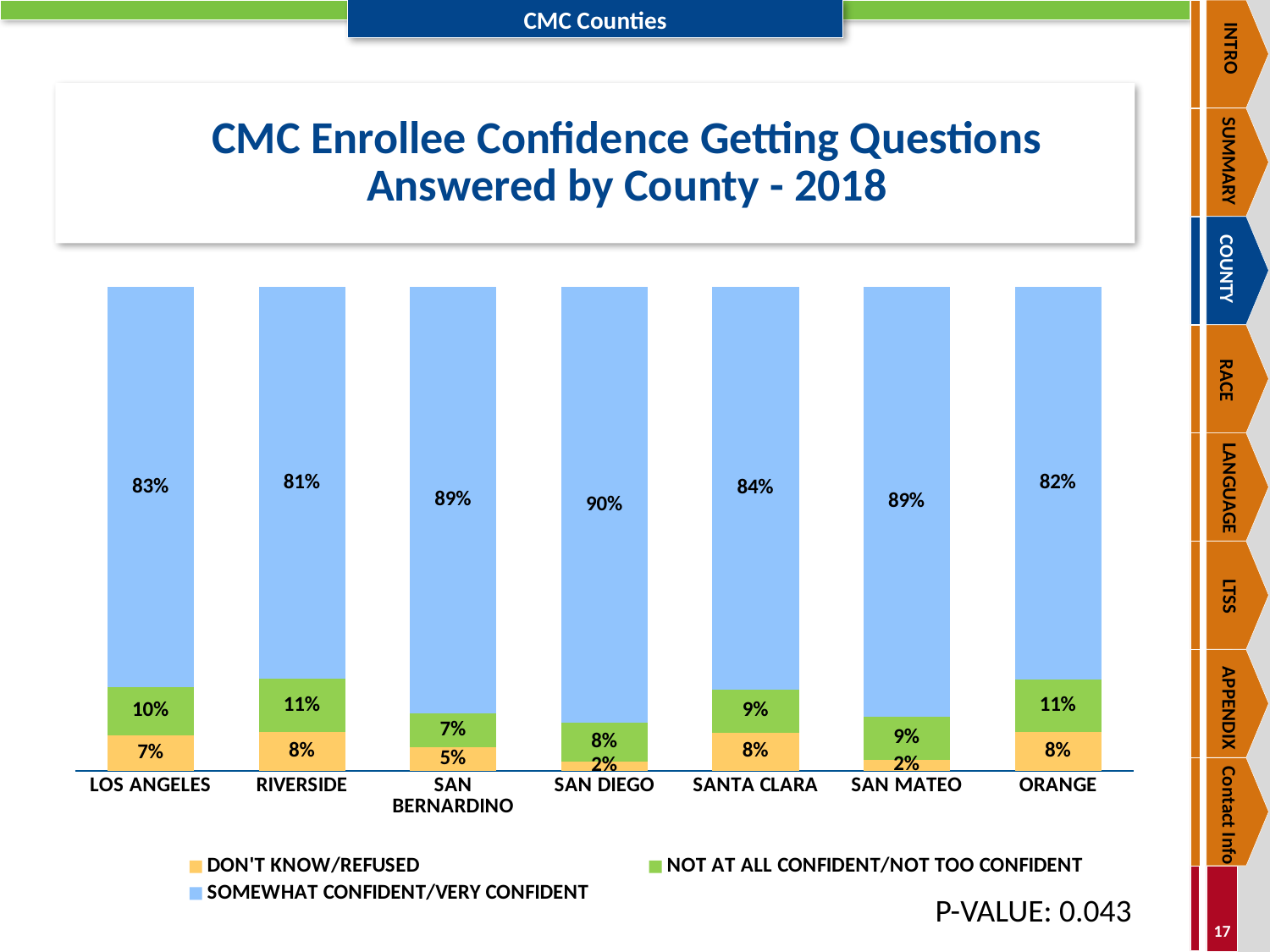
What is the Not At All Confident/Not Too Confident value for Orange? 11% How many counties are shown on the chart? 7 Which county has the lowest Somewhat Confident/Very Confident percentage? Riverside What kind of chart is shown on the slide? Stacked bar chart What is the combined percentage of Don't Know/Refused and Not At All Confident/Not Too Confident for San Mateo? 11% Which county has the highest Somewhat Confident/Very Confident percentage? San Diego What is the Don't Know/Refused value for Riverside? 8% What percentage of San Diego enrollees were somewhat confident/very confident? 90% What p-value is shown on the slide? 0.043 Which county has a higher Not At All Confident/Not Too Confident percentage, Los Angeles or Santa Clara? Los Angeles How many series does the legend list? 3 What is the difference between the Somewhat Confident/Very Confident percentages for San Diego and Riverside? 9%